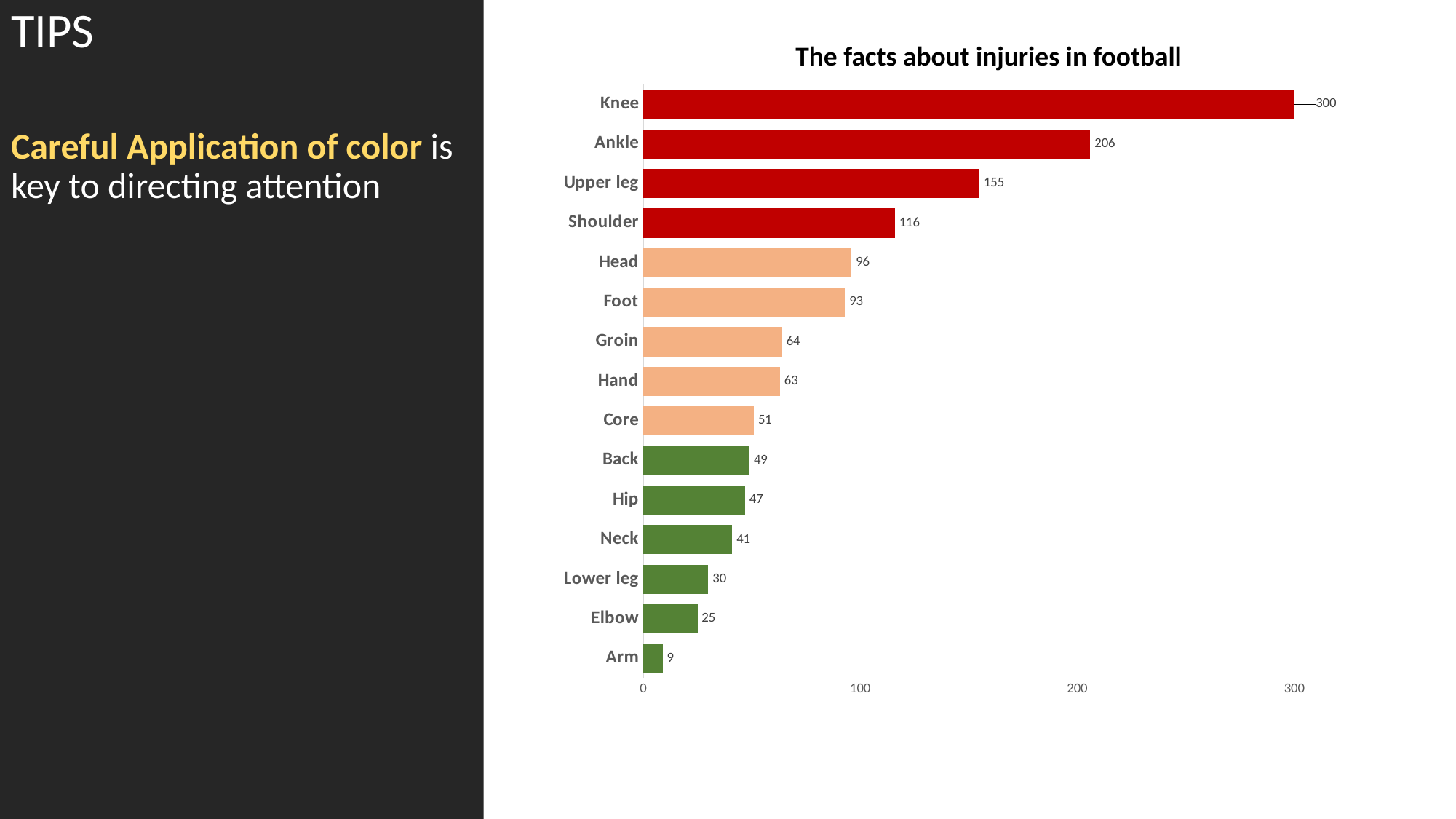
Which category has the highest value? Knee What is the difference between the values for Knee and Ankle? 94 Which category has the lowest value? Arm How many categories are shown in the chart? 15 What is the value for Knee? 300 What kind of chart is shown on the slide? Bar chart What is the value for Shoulder? 116 What is the difference between the values for Head and Foot? 3 Which is larger, the value for Upper leg or the value for Shoulder? Upper leg Is the value for Ankle greater or less than 200? greater What is the title of the chart? The facts about injuries in football What is the value for Lower leg? 30